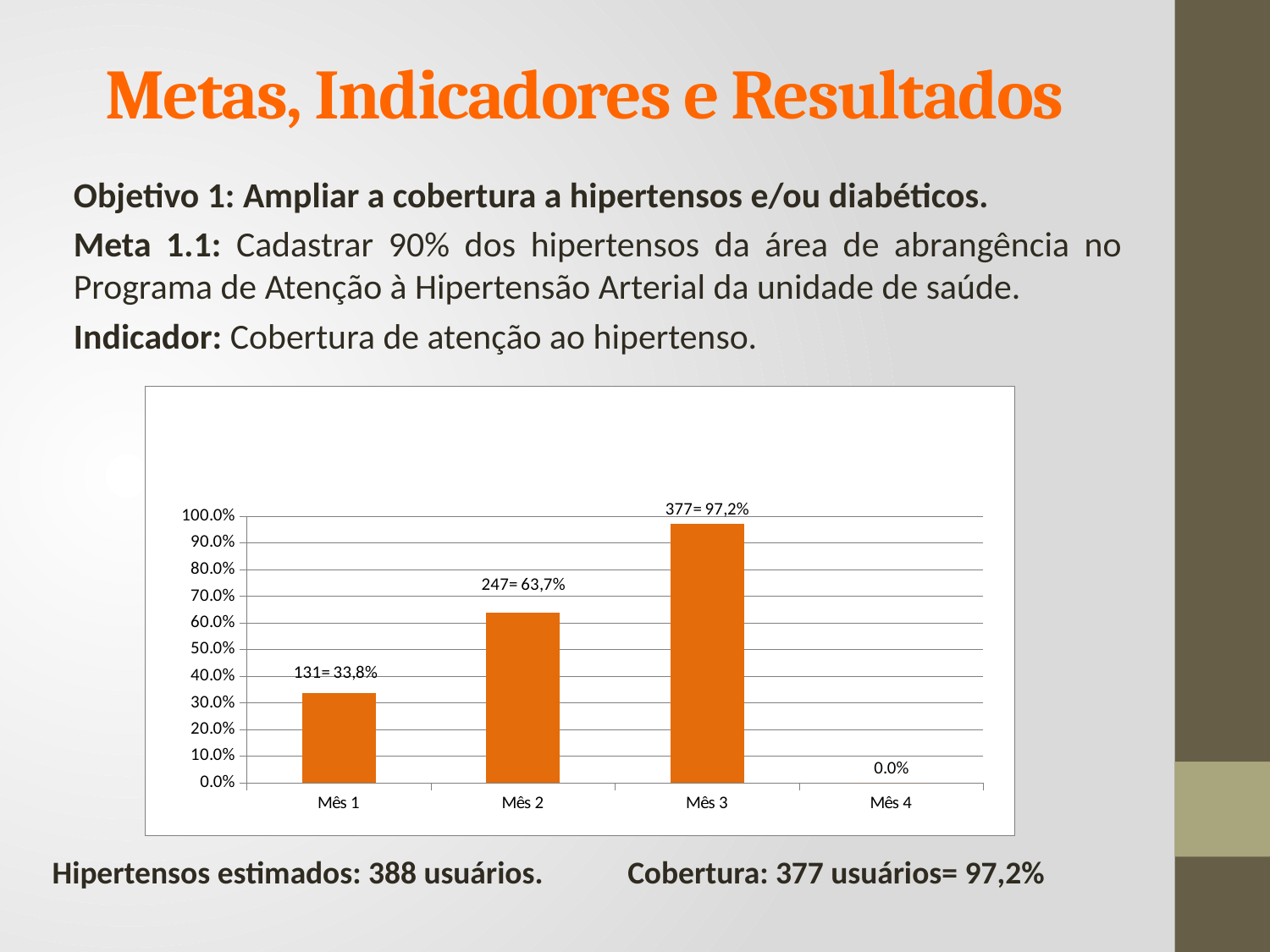
Is the value for Mês 3 greater or less than 90.0%? greater Do the values rise or fall from Mês 1 to Mês 3? Rise Which month has the highest bar? Mês 3 How many months (categories) are shown on the x axis? 4 Which month has the lowest value? Mês 4 What is the data label shown for Mês 1? 131= 33,8% Which is larger, the value for Mês 1 or the value for Mês 2? Mês 2 What is the data label shown for Mês 3? 377= 97,2% What value is shown for Mês 4? 0.0% What kind of chart is shown on the slide? Bar chart Is the value for Mês 1 greater or less than 40.0%? less What is the data label shown for Mês 2? 247= 63,7%